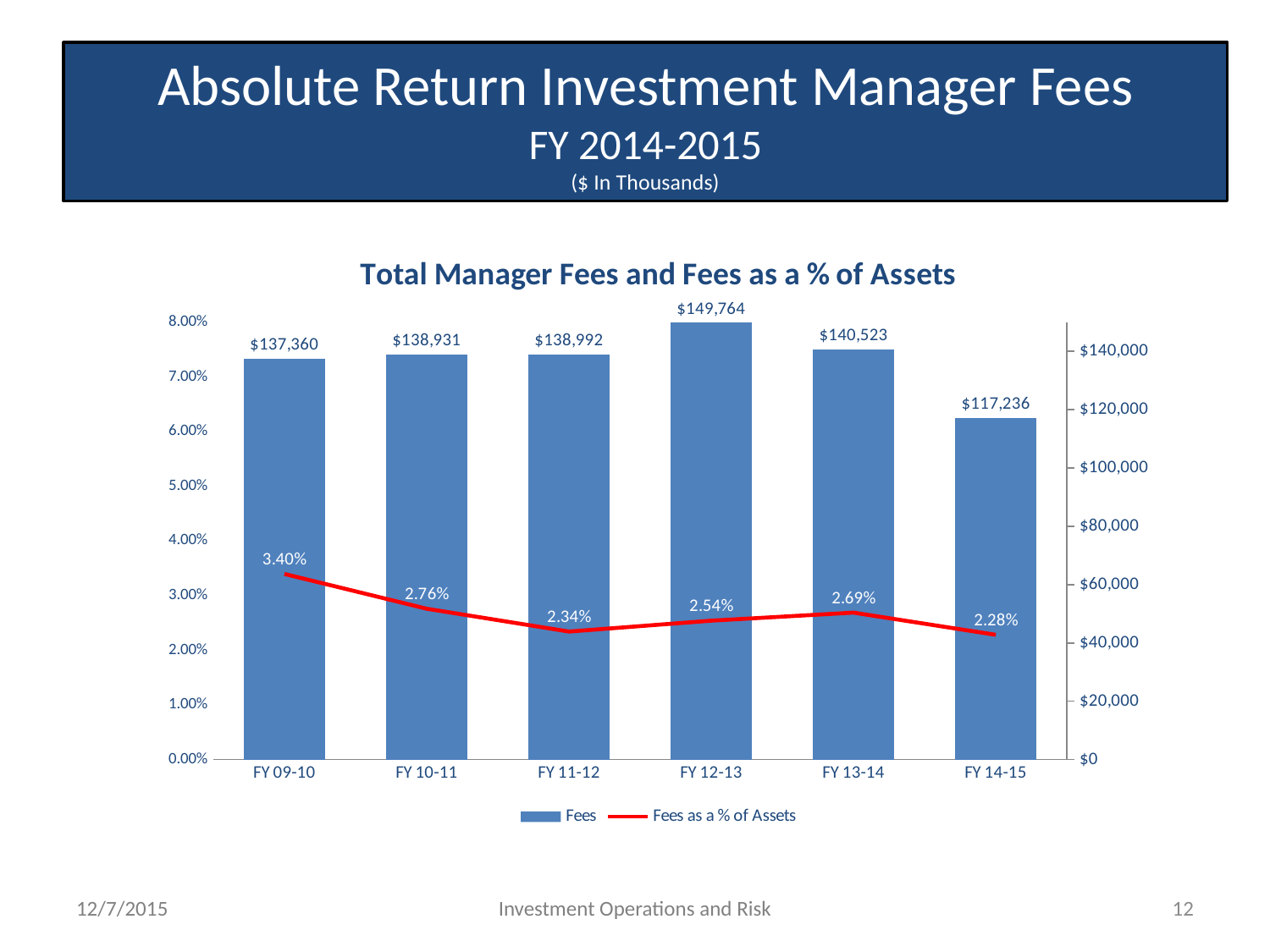
What is the value of Fees as a % of Assets for FY 09-10? 3.40% How many series does the legend list? 2 Which is larger, Fees as a % of Assets for FY 10-11 or for FY 13-14? FY 10-11 What is the difference in Fees between FY 12-13 and FY 14-15? $32,528 What is the value of Fees for FY 14-15? $117,236 What kind of chart is used to show the Fees series? bar chart How many fiscal years are shown on the x axis? 6 What is the value of Fees for FY 12-13? $149,764 Which fiscal year has the highest Fees? FY 12-13 Which fiscal year has the lowest Fees as a % of Assets? FY 14-15 What is the title of the chart? Total Manager Fees and Fees as a % of Assets Is the Fees value for FY 14-15 greater or less than $120,000? less